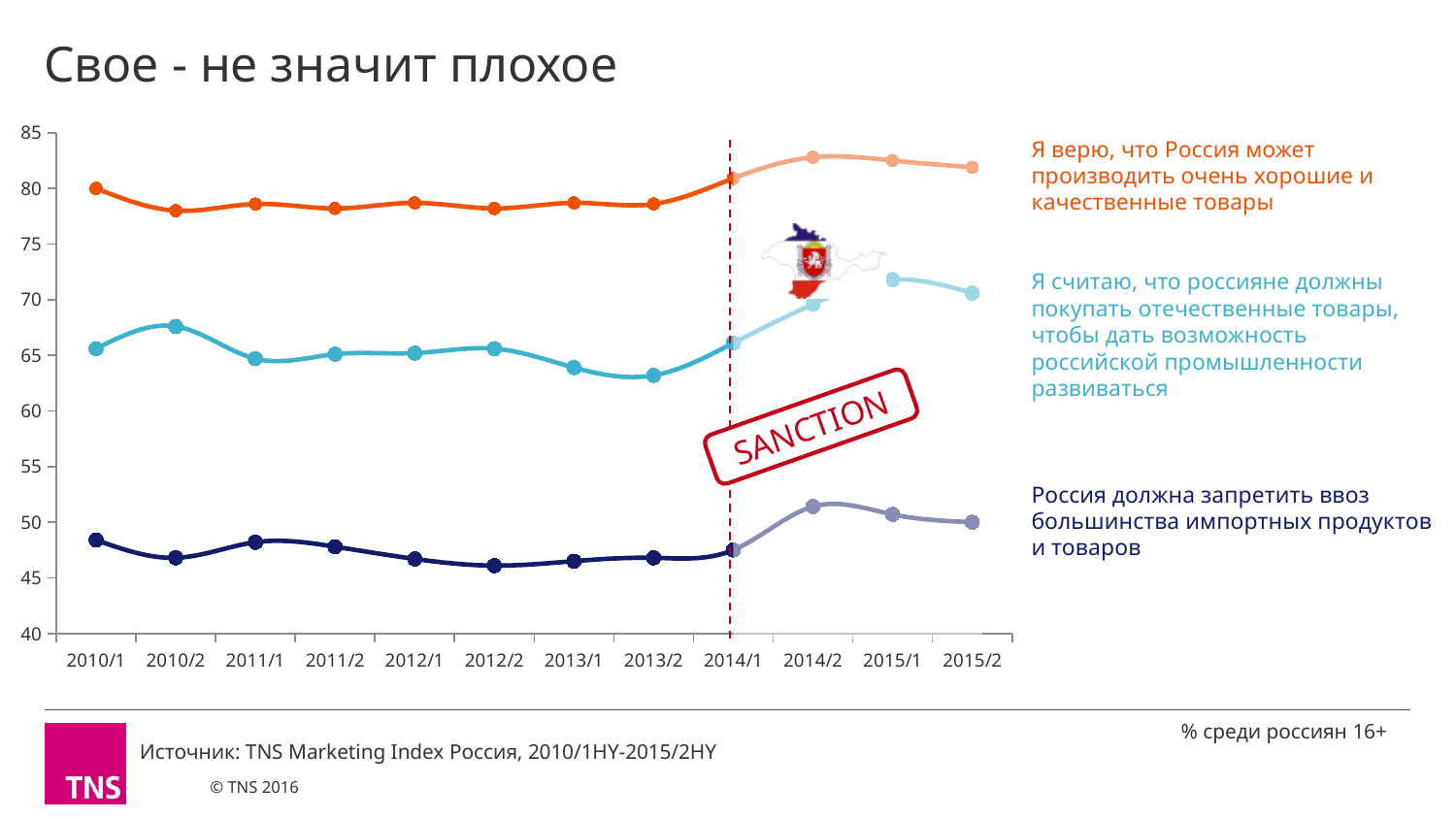
How many time points are shown along the x axis of the chart? 12 What kind of chart is shown on the slide? line chart Does the line 'Россия должна запретить ввоз большинства импортных продуктов и товаров' rise or fall between 2014/1 and 2014/2? rise At which time point does the line 'Я считаю, что россияне должны покупать отечественные товары...' reach its highest value? 2015/1 How many lines (series) are plotted on the chart? 3 At 2010/1, which line is higher: 'Я верю, что Россия может производить очень хорошие и качественные товары' or 'Россия должна запретить ввоз большинства импортных продуктов и товаров'? Я верю, что Россия может производить очень хорошие и качественные товары Is the value for 2012/2 on the line 'Россия должна запретить ввоз большинства импортных продуктов и товаров' greater or less than 50? less Is the value for 2010/1 on the line 'Я верю, что Россия может производить очень хорошие и качественные товары' greater or less than 75? greater Is the value for 2015/1 on the line 'Я считаю, что россияне должны покупать отечественные товары...' greater or less than 70? greater What label is written on the stamp placed over the dashed vertical line at 2014/1? SANCTION